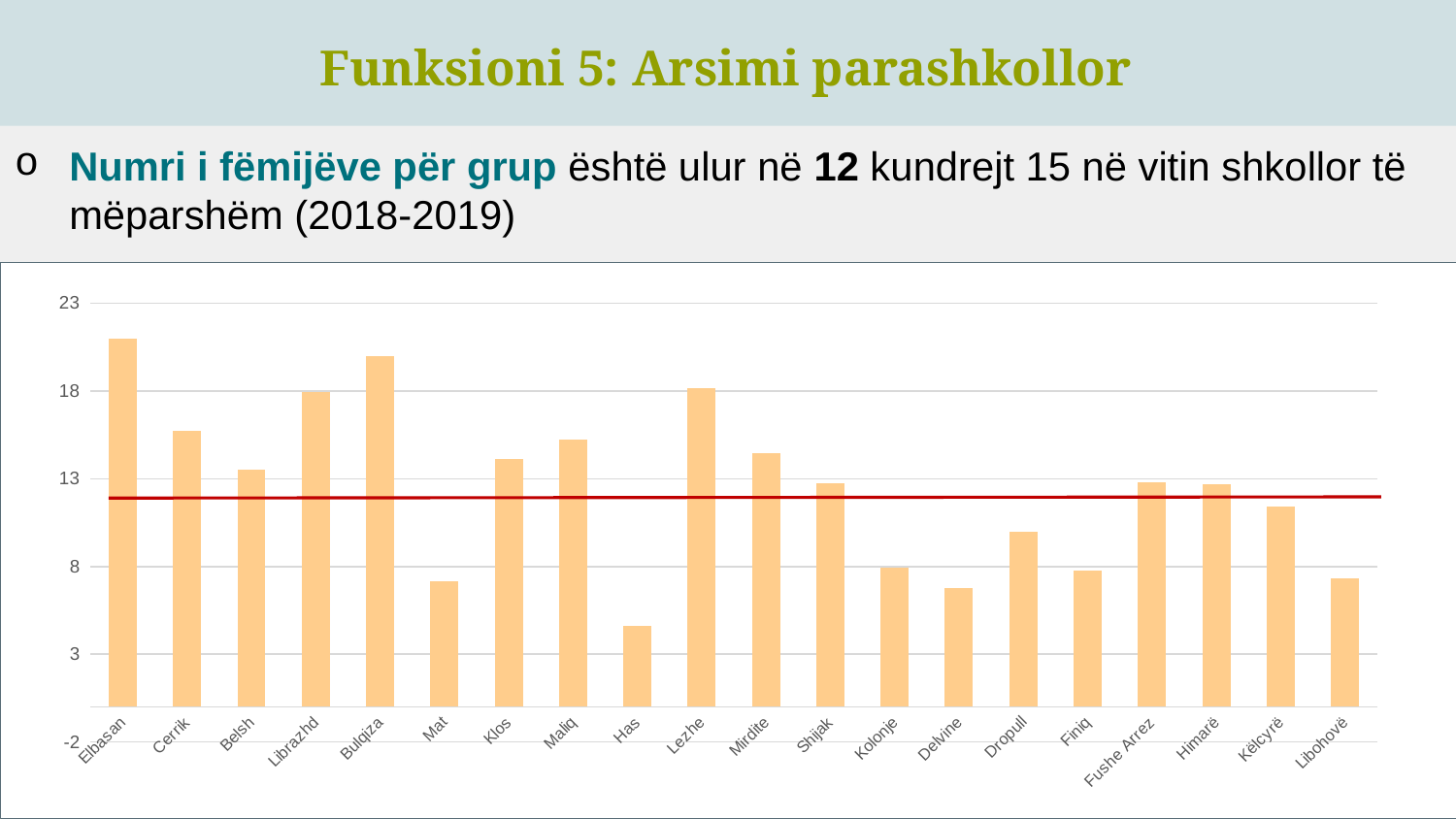
Is the value for Mat greater or less than 8? less Is the value for Cerrik greater or less than 13? greater Is the value for Has greater or less than 8? less Which category has the lowest bar in the chart? Has Which category has the highest bar in the chart? Elbasan What colour are the bars in the chart? orange What kind of chart is shown on the slide? bar chart How many categories (municipalities) are shown on the x axis of the chart? 20 Which has the larger value, Elbasan or Mat? Elbasan Which has the larger value, Dropull or Has? Dropull